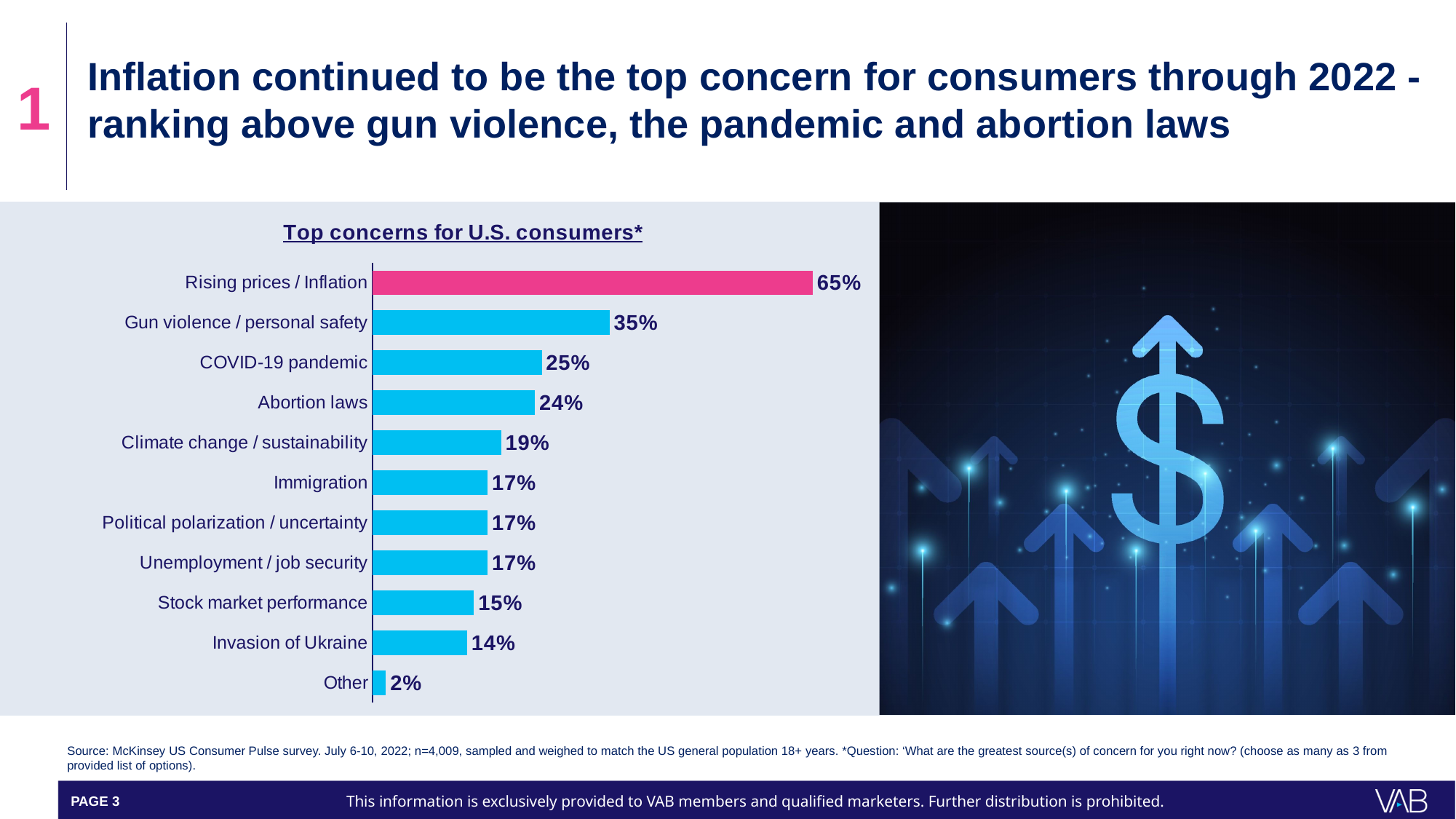
What is the title of the chart? Top concerns for U.S. consumers* What is the difference between the values for COVID-19 pandemic and Stock market performance? 10% What percentage of U.S. consumers cited Rising prices / Inflation as a top concern? 65% Which concern has the highest value in the chart? Rising prices / Inflation Which has a larger value, COVID-19 pandemic or Climate change / sustainability? COVID-19 pandemic Which category has the lowest value in the chart? Other How many categories are shown in the chart? 11 What is the value shown for Abortion laws? 24% What kind of chart is shown on the slide? Bar chart What is the value shown for Invasion of Ukraine? 14% What is the difference between the values for Rising prices / Inflation and Gun violence / personal safety? 30% What is the value shown for Gun violence / personal safety? 35%